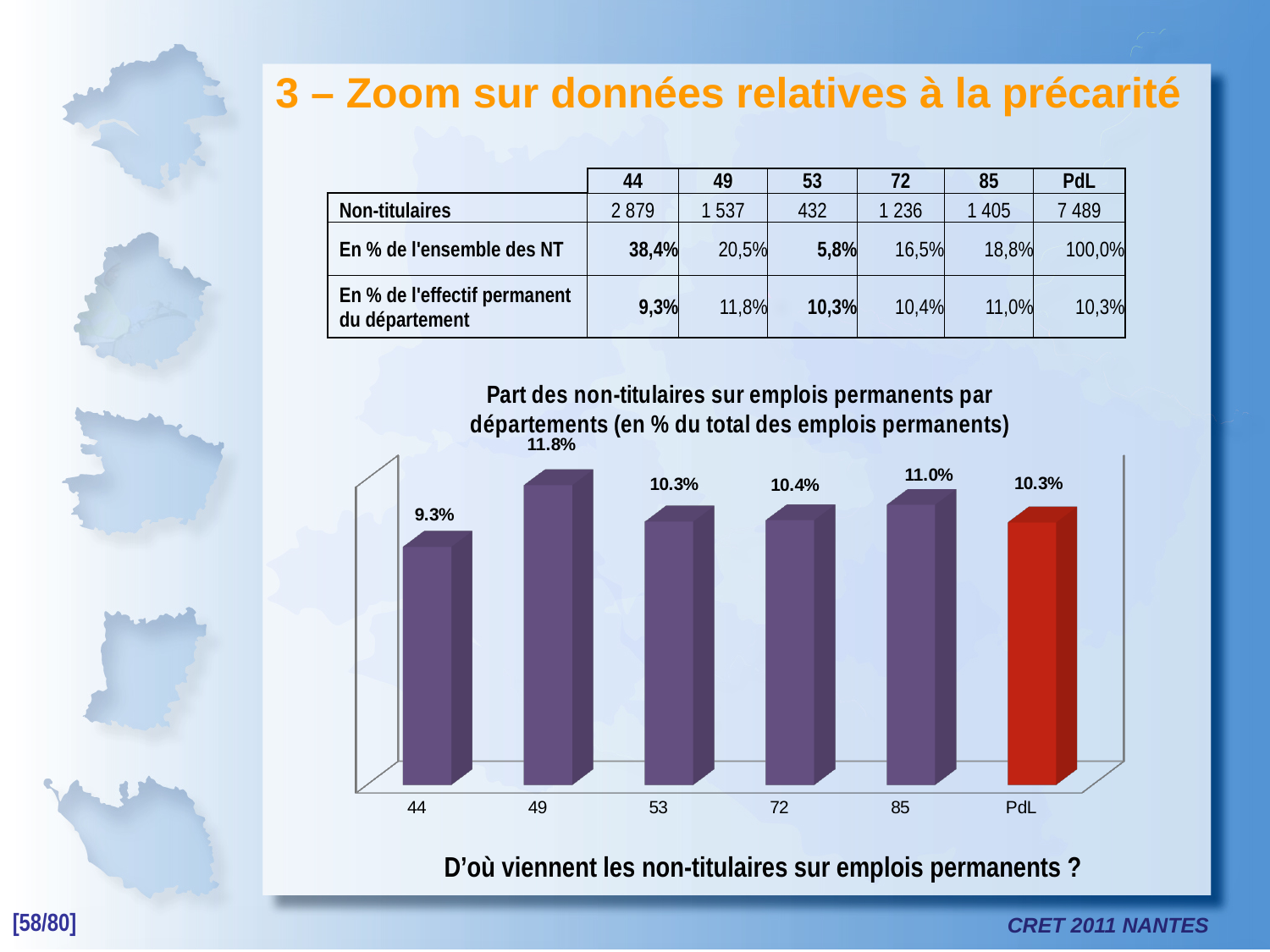
Which has a larger value in the chart, 49 or 85? 49 What is the value shown for department 85 in the chart? 11.0% How many categories are shown on the x axis of the chart? 6 Which category has the lowest value in the chart? 44 What is the value shown for department 44 in the chart? 9.3% What type of chart is shown on the slide? bar chart What colour is the bar for PdL in the chart? red What is the difference between the values for 49 and 44 in the chart? 2.5% What is the difference between the values for 85 and PdL in the chart? 0.7% What is the value shown for PdL in the chart? 10.3% What is the value shown for department 49 in the chart? 11.8% Which category has the highest value in the chart? 49